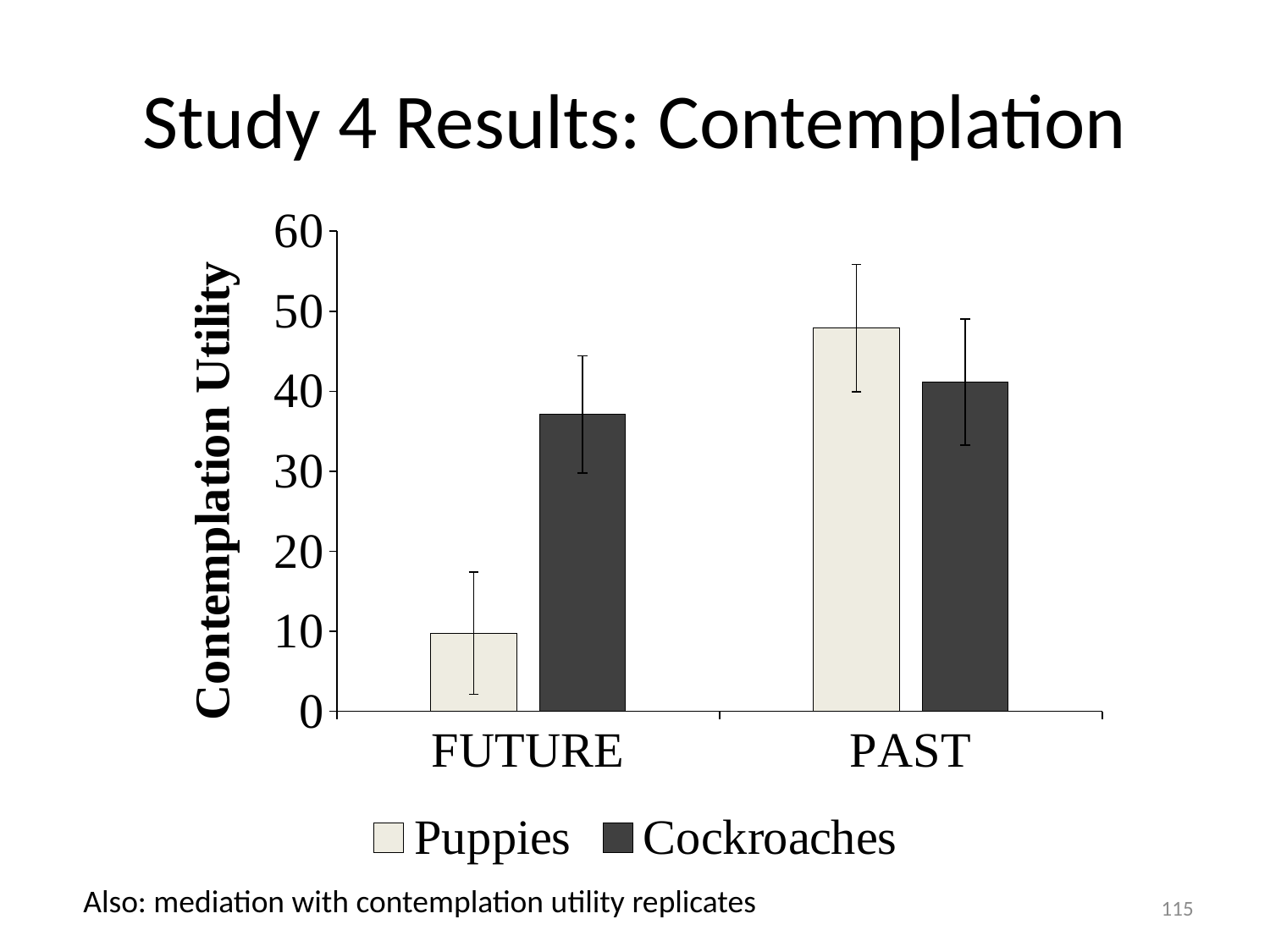
Does the value for Puppies rise or fall from FUTURE to PAST? rise Which series are listed in the legend? Puppies and Cockroaches What kind of chart is shown on the slide? bar chart In the FUTURE condition, which series has the larger value, Puppies or Cockroaches? Cockroaches Is the value for Puppies in the PAST condition greater or less than 40? greater Which bar is the lowest in the chart? Puppies in FUTURE Is the value for Puppies in the FUTURE condition greater or less than 20? less How many series does the legend list? 2 Is the value for Cockroaches in the PAST condition greater or less than 50? less How many categories are shown on the x axis? 2 What is the label of the vertical axis? Contemplation Utility